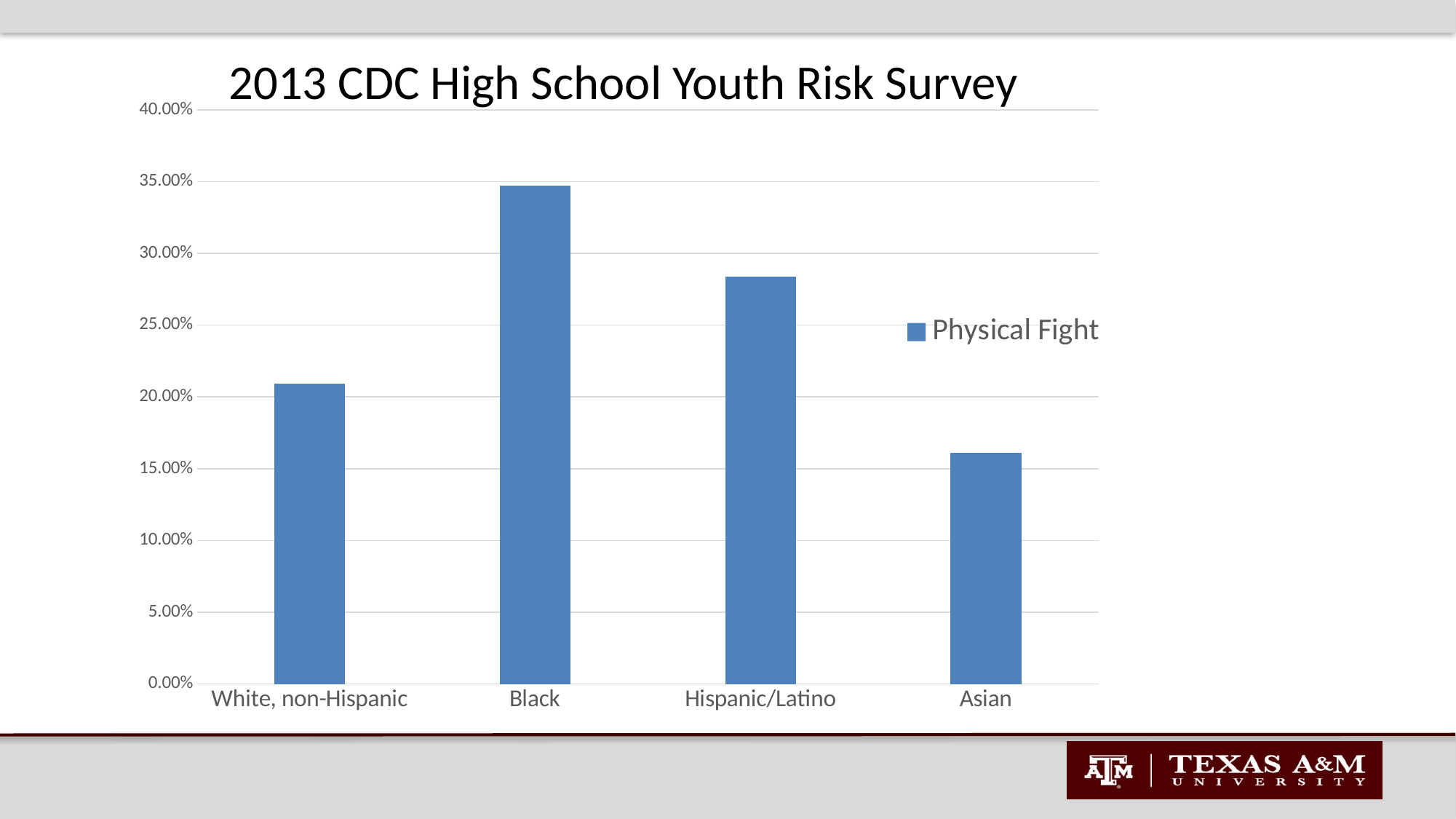
Is the Physical Fight value for Black greater or less than 30.00%? greater What kind of chart is shown on the slide? bar chart Which category has the lowest Physical Fight value? Asian Which has a larger Physical Fight value, White, non-Hispanic or Hispanic/Latino? Hispanic/Latino What is the title of the chart? 2013 CDC High School Youth Risk Survey What series name appears in the legend? Physical Fight How many series does the legend list? 1 Is the Physical Fight value for White, non-Hispanic greater or less than 25.00%? less How many categories are shown on the x axis? 4 Which category has the highest Physical Fight value? Black Is the Physical Fight value for Hispanic/Latino greater or less than 25.00%? greater